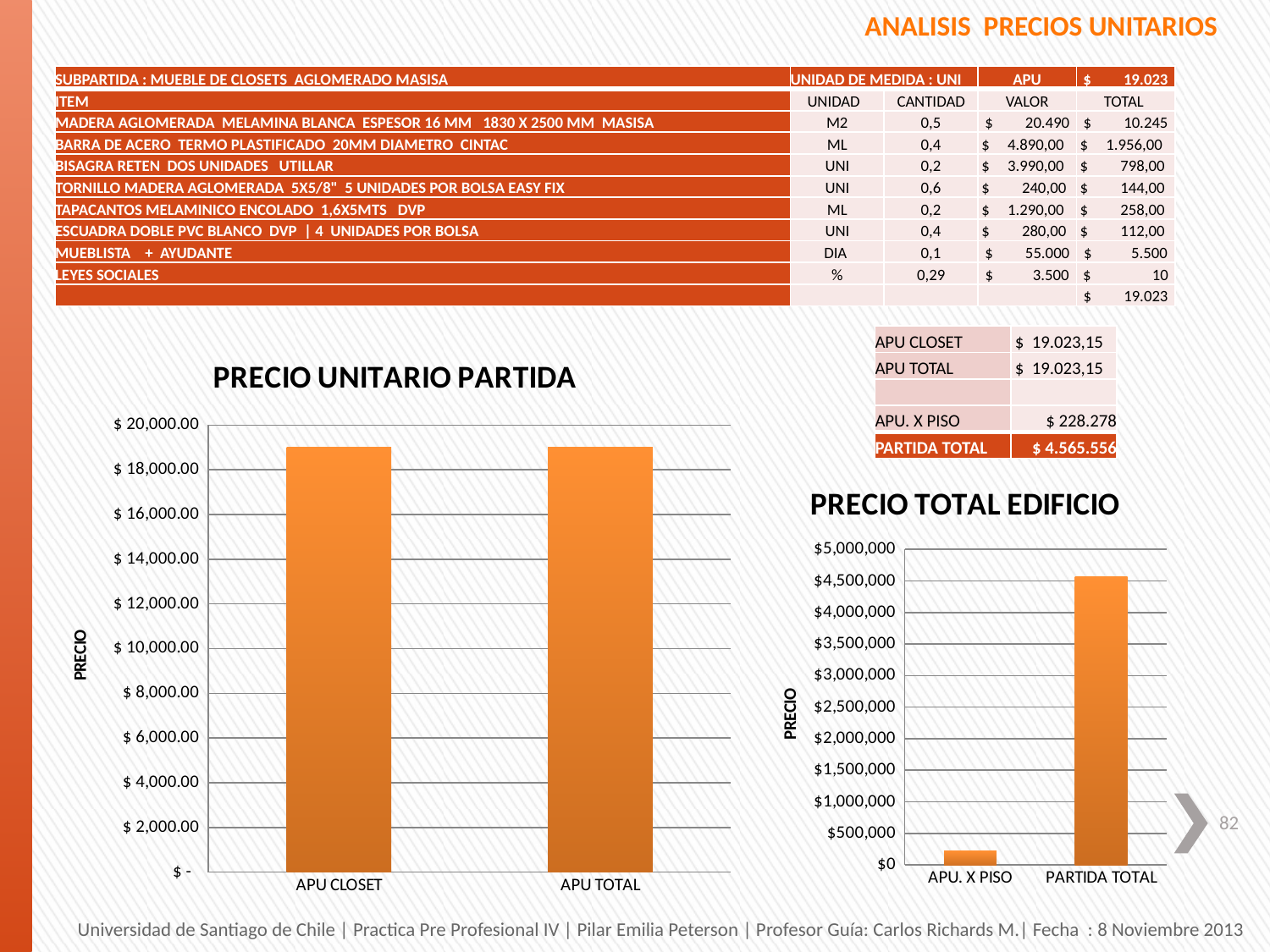
In the PRECIO TOTAL EDIFICIO chart, which is larger, APU. X PISO or PARTIDA TOTAL? PARTIDA TOTAL What kind of chart is the PRECIO UNITARIO PARTIDA chart? bar chart In the PRECIO TOTAL EDIFICIO chart, which category has the lowest value? APU. X PISO How many categories are shown on the x axis of the PRECIO UNITARIO PARTIDA chart? 2 In the PRECIO TOTAL EDIFICIO chart, which category has the highest value? PARTIDA TOTAL In the PRECIO TOTAL EDIFICIO chart, is the value for PARTIDA TOTAL greater or less than $4,000,000? greater In the PRECIO TOTAL EDIFICIO chart, is the value for APU. X PISO greater or less than $500,000? less In the PRECIO UNITARIO PARTIDA chart, is the value for APU TOTAL greater or less than $ 20,000.00? less What kind of chart is the PRECIO TOTAL EDIFICIO chart? bar chart How many categories are shown on the x axis of the PRECIO TOTAL EDIFICIO chart? 2 What is the y-axis title of the PRECIO UNITARIO PARTIDA chart? PRECIO